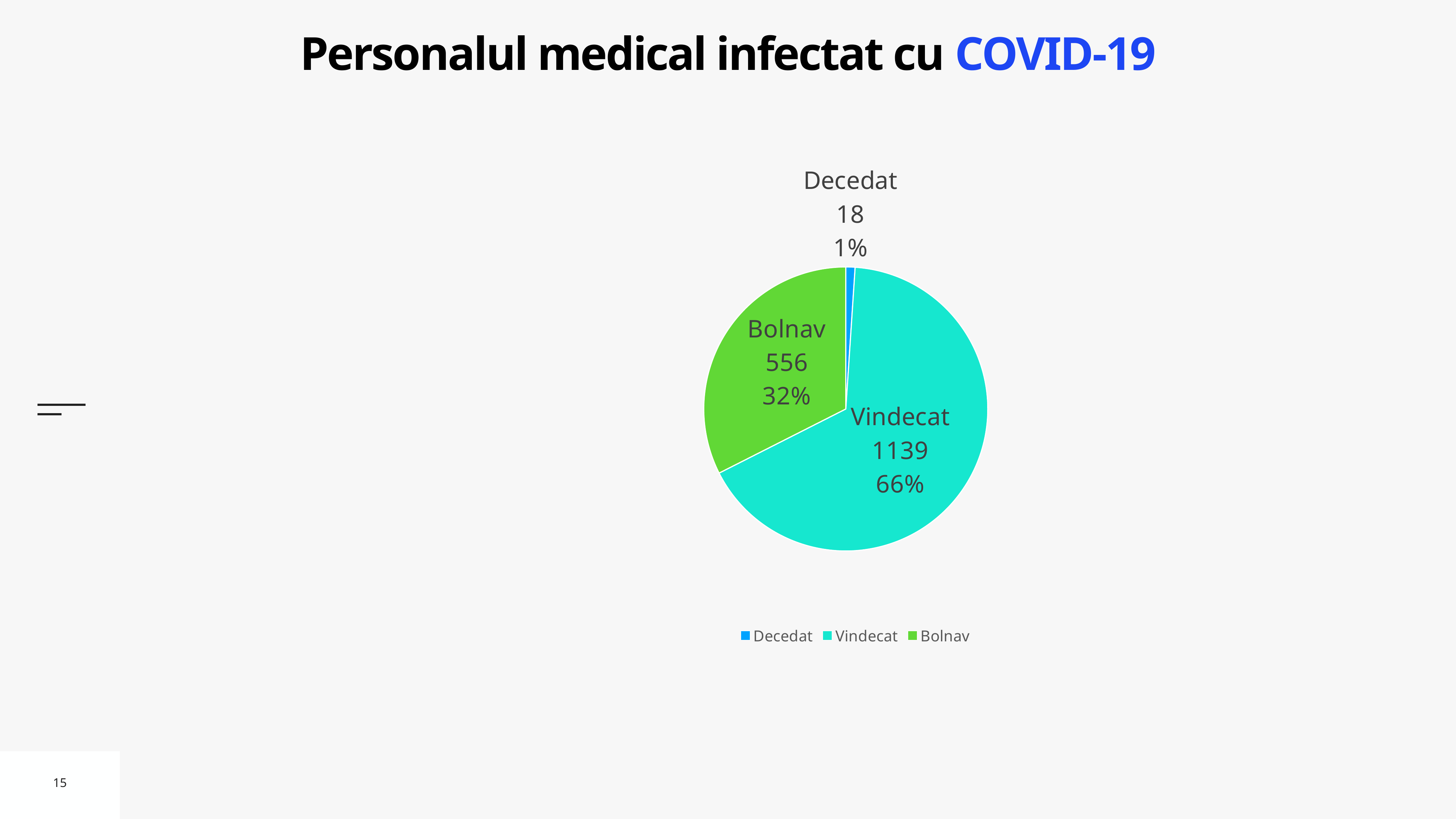
Which category has the smallest slice? Decedat What share of the pie does Bolnav represent? 32% What share of the pie does Vindecat represent? 66% Which is larger, the value for Bolnav or the value for Decedat? Bolnav What is the total of all three slices? 1713 What is the value for Bolnav? 556 What is the value for Vindecat? 1139 What is the value for Decedat? 18 Which category has the largest slice? Vindecat What is the difference between the values for Vindecat and Bolnav? 583 How many slices does the pie chart have? 3 What kind of chart is shown on the slide? pie chart